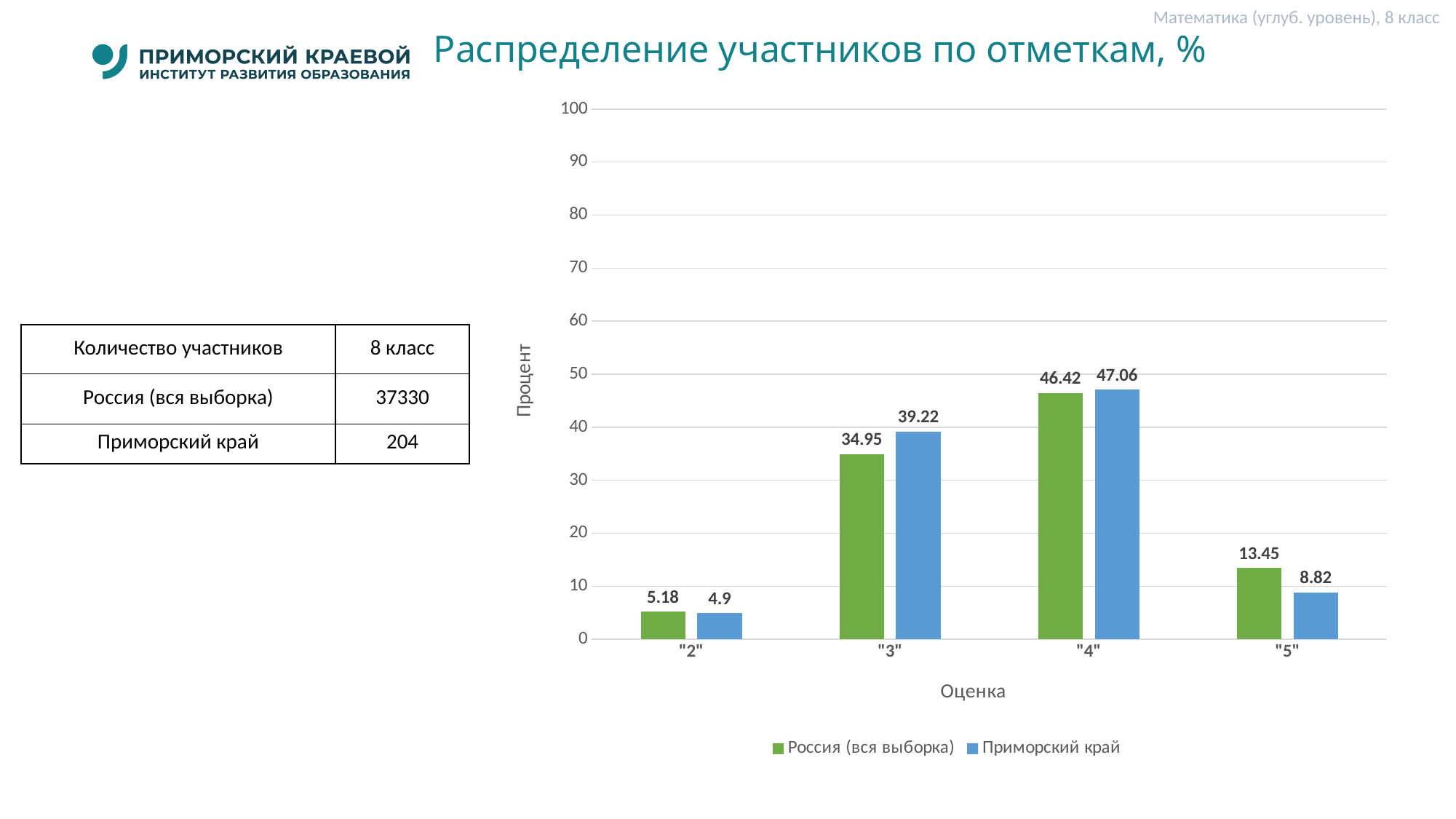
How many grade categories are shown on the x axis? 4 What is the value for Россия (вся выборка) for grade "2"? 5.18 Which is larger for grade "5": Россия (вся выборка) or Приморский край? Россия (вся выборка) What is the value for Приморский край for grade "3"? 39.22 What is the difference between Приморский край and Россия (вся выборка) for grade "3"? 4.27 How many series does the legend list? 2 What is the value for Россия (вся выборка) for grade "5"? 13.45 What kind of chart is shown on the slide? bar chart Is the value for Приморский край for grade "4" greater or less than 40? greater Which grade has the lowest value for Россия (вся выборка)? "2" What is the label of the y axis? Процент Which grade has the highest value for Приморский край? "4"